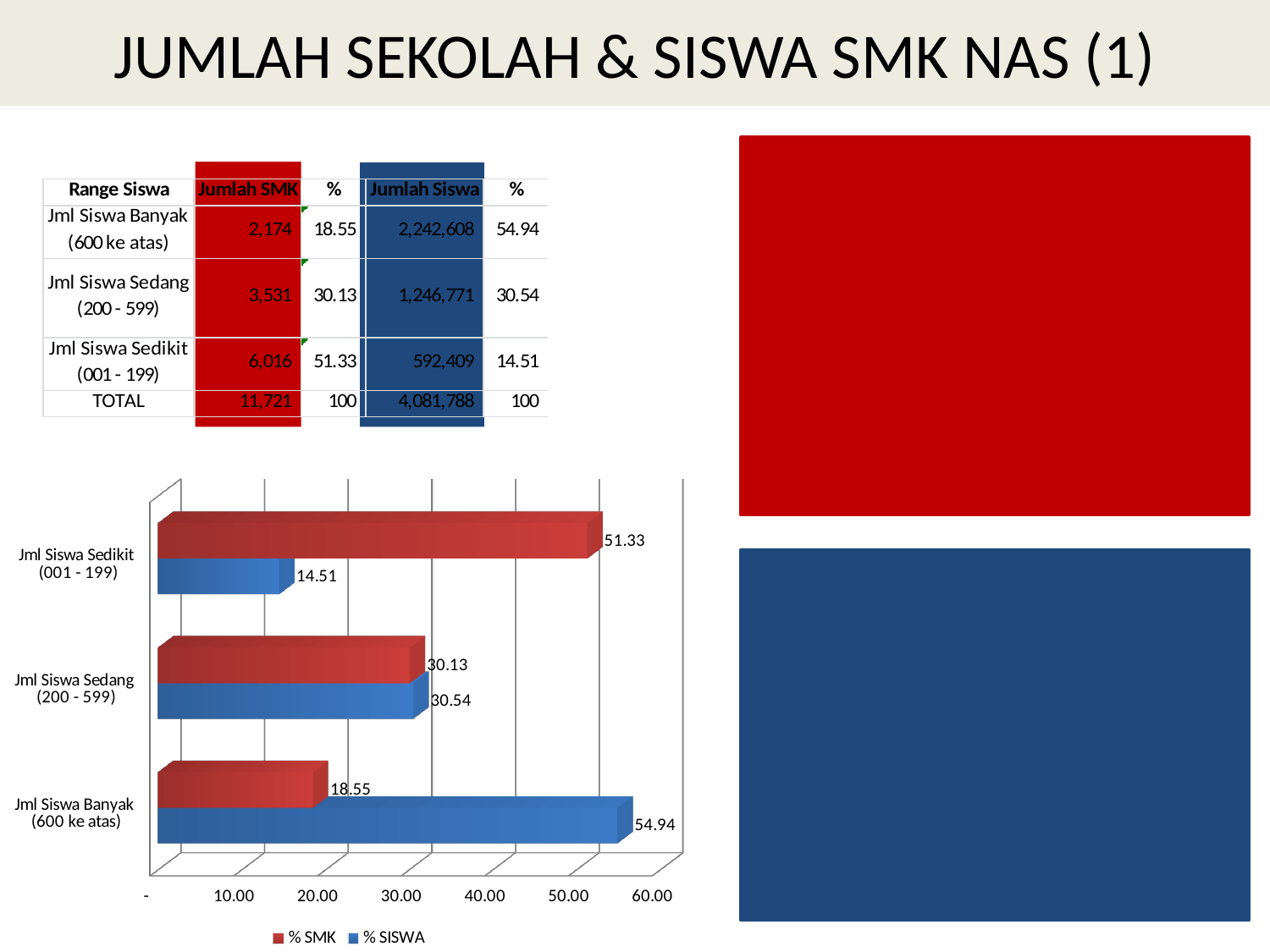
What type of chart is shown on the slide? Bar chart What is the % SMK value for Jml Siswa Banyak (600 ke atas)? 18.55 Is the % SISWA value for Jml Siswa Banyak (600 ke atas) greater or less than 50.00? greater What is the % SMK value for Jml Siswa Sedikit (001 - 199)? 51.33 What is the % SISWA value for Jml Siswa Sedang (200 - 599)? 30.54 What is the % SISWA value for Jml Siswa Banyak (600 ke atas)? 54.94 What is the difference between the % SMK and % SISWA values for Jml Siswa Sedikit (001 - 199)? 36.82 How many series does the chart legend list? 2 Which category has the highest % SMK value? Jml Siswa Sedikit (001 - 199) How many categories are shown on the chart? 3 For Jml Siswa Banyak (600 ke atas), which is larger: % SMK or % SISWA? % SISWA Which category has the lowest % SISWA value? Jml Siswa Sedikit (001 - 199)